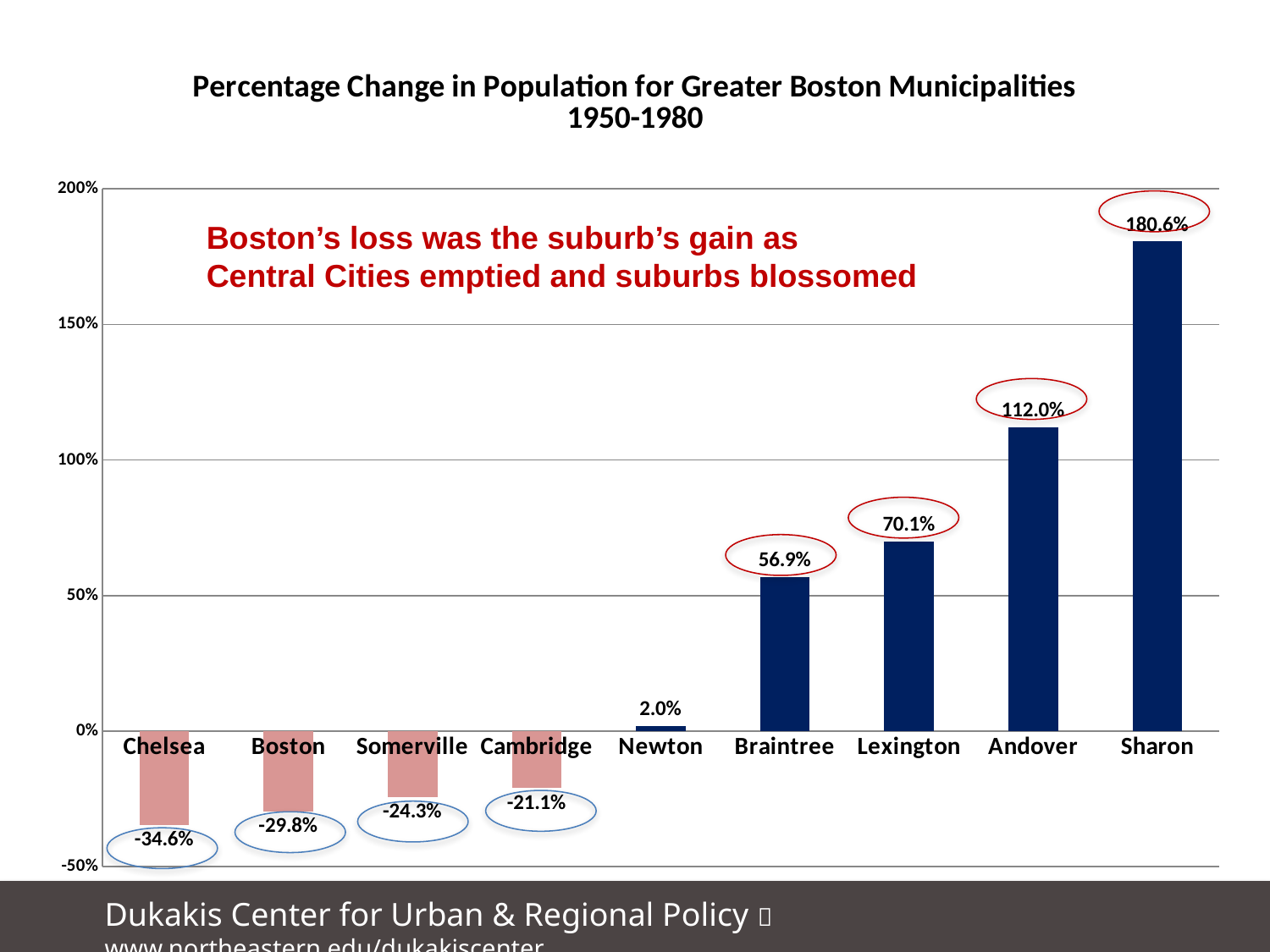
What is the percentage change in population for Boston? -29.8% What kind of chart is shown on the slide? Bar chart What is the percentage change in population for Sharon? 180.6% Which municipality has the lowest percentage change in population? Chelsea Which has a larger percentage change in population, Braintree or Lexington? Lexington How many municipalities are shown on the chart? 9 Is the value for Andover greater or less than 100%? greater What is the percentage change in population for Newton? 2.0% Do the values rise or fall moving from left to right along the x axis? Rise What is the difference between the percentage change for Andover and Lexington? 41.9% Which municipality has the highest percentage change in population? Sharon What is the title of the chart? Percentage Change in Population for Greater Boston Municipalities 1950-1980